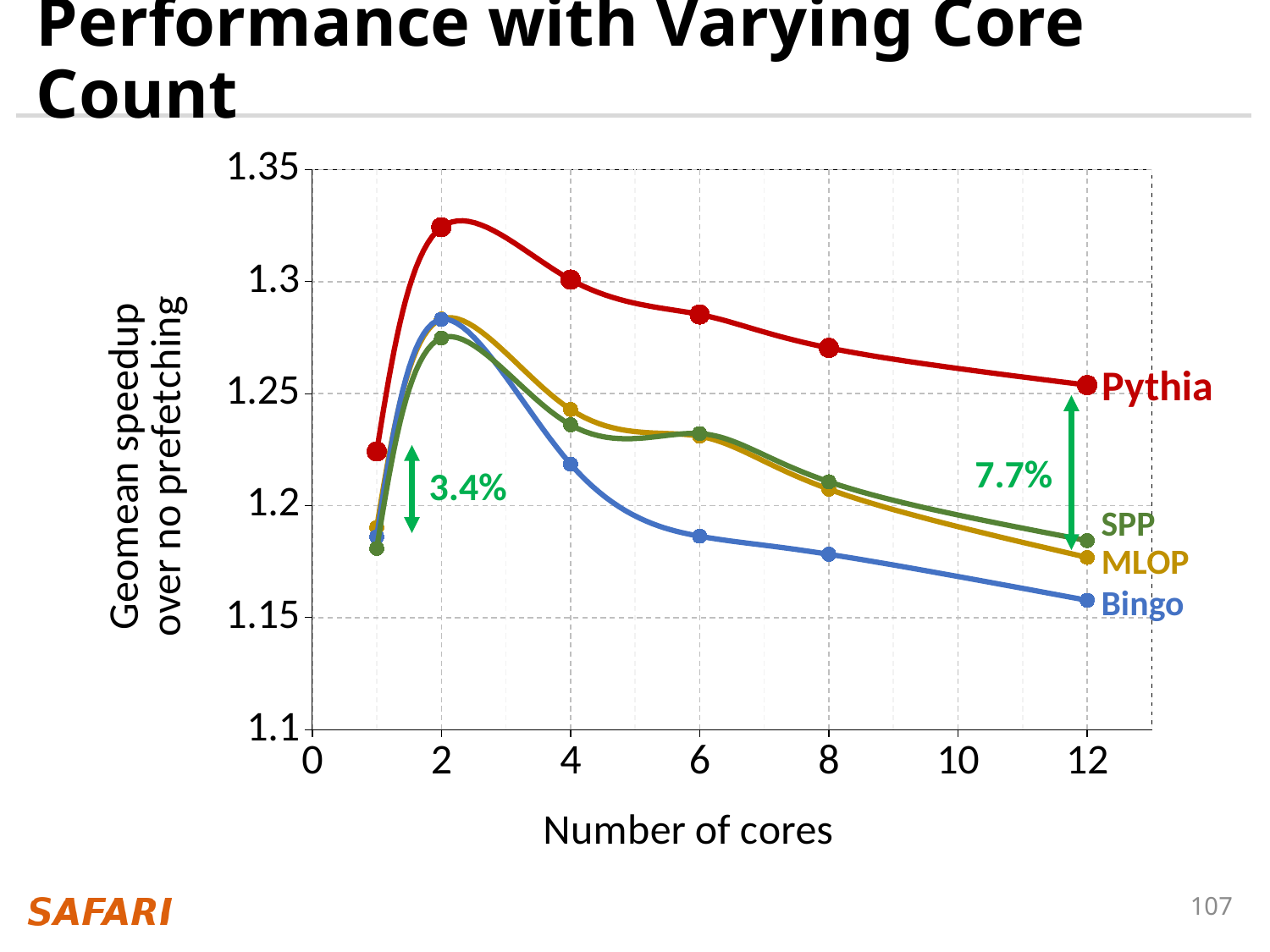
Is the geomean speedup for Pythia at 2 cores greater or less than 1.3? greater Does the geomean speedup for Pythia rise or fall as the number of cores increases from 2 to 12? fall Is the geomean speedup for Pythia at 1 core greater or less than 1.2? greater Which series has the highest geomean speedup at 12 cores? Pythia Is the geomean speedup for Bingo at 12 cores greater or less than 1.2? less Which series has the lowest geomean speedup at 12 cores? Bingo How many series (prefetchers) are plotted on the chart? 4 How many core-count data points are plotted for the Pythia series? 6 What percentage improvement is annotated between Pythia and SPP at 12 cores? 7.7% What kind of chart is shown on the slide? line chart What percentage improvement is annotated near the 1-core data points? 3.4% At 4 cores, which has the larger geomean speedup, Pythia or Bingo? Pythia